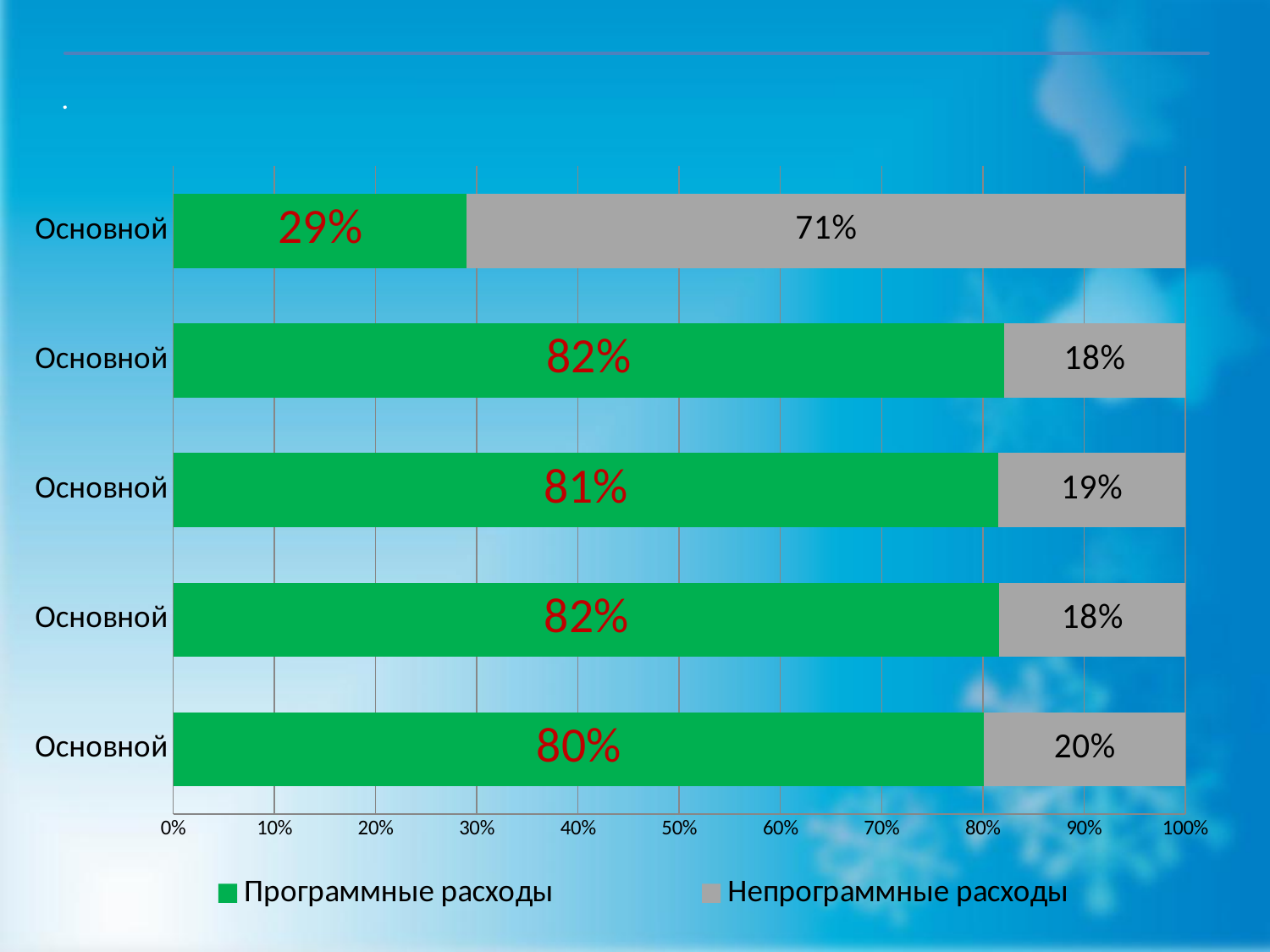
Which is larger: Программные расходы in the bottom bar or in the third bar from the top? The third bar from the top (81%) What colour represents Программные расходы in the chart? Green What is the value of Непрограммные расходы in the third bar from the top? 19% What is the value of Программные расходы in the bottom bar? 80% What kind of chart is shown on the slide? Bar chart In the top bar, how much larger is Непрограммные расходы than Программные расходы? 42 percentage points What is the value of Непрограммные расходы in the top bar? 71% How many bars are plotted in the chart? 5 Which bar has the smallest Программные расходы share? The top bar (29%) What is the value of Программные расходы in the top bar? 29% Which bar has the largest Непрограммные расходы share? The top bar (71%) How many series does the legend list? 2